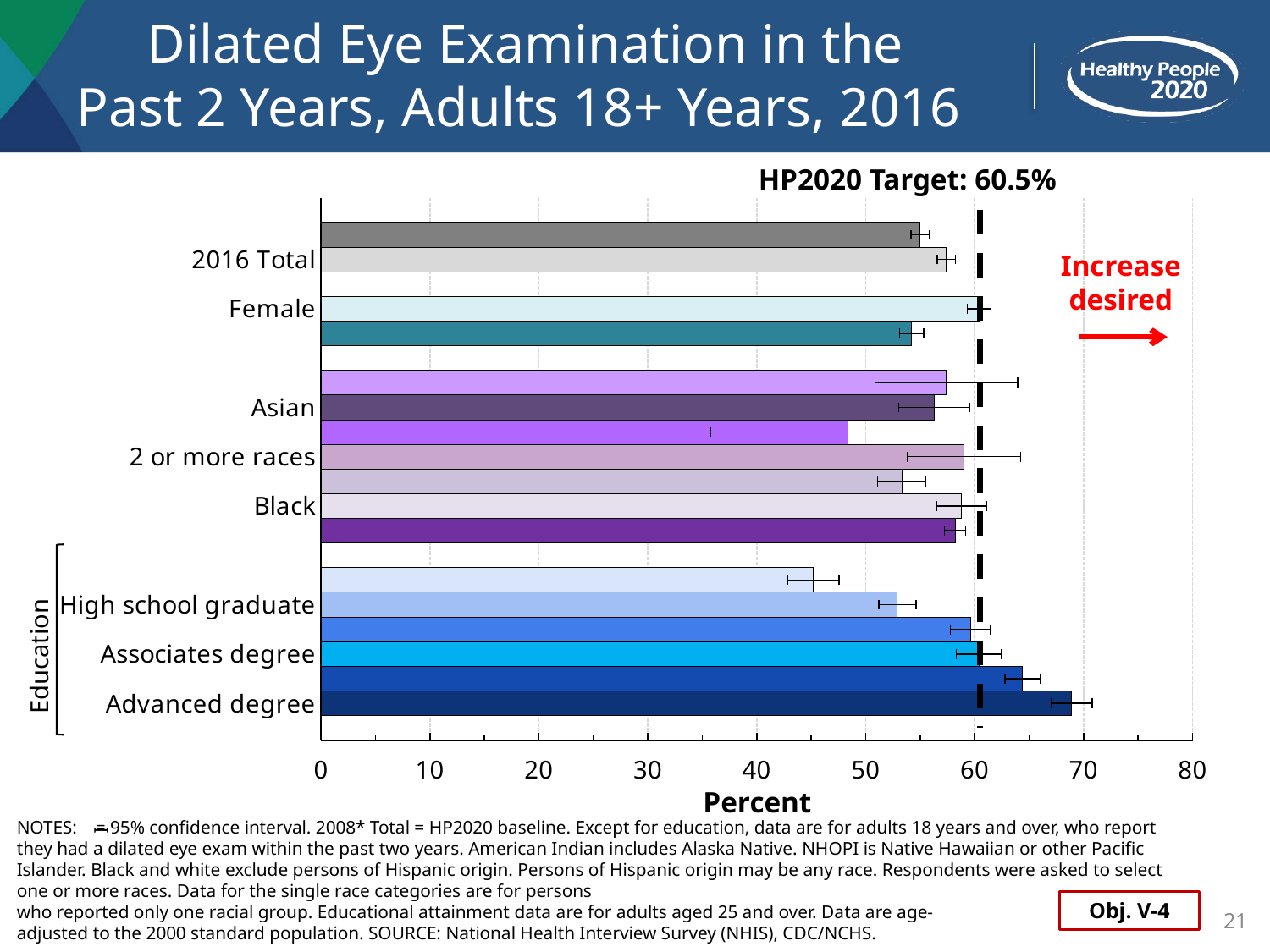
What is the HP2020 Target value shown on the slide? 60.5% How many bars are in the Education group of the chart? 6 Is the value for High school graduate greater or less than 60? less What kind of chart is shown on the slide? bar chart What is the label of the x axis? Percent Which labeled category has the longest bar in the chart? Advanced degree Is the value for 2016 Total greater or less than 60? less Is the value for Advanced degree greater or less than 60? greater Which has the larger value, Black or High school graduate? Black Which has the larger value, Advanced degree or High school graduate? Advanced degree